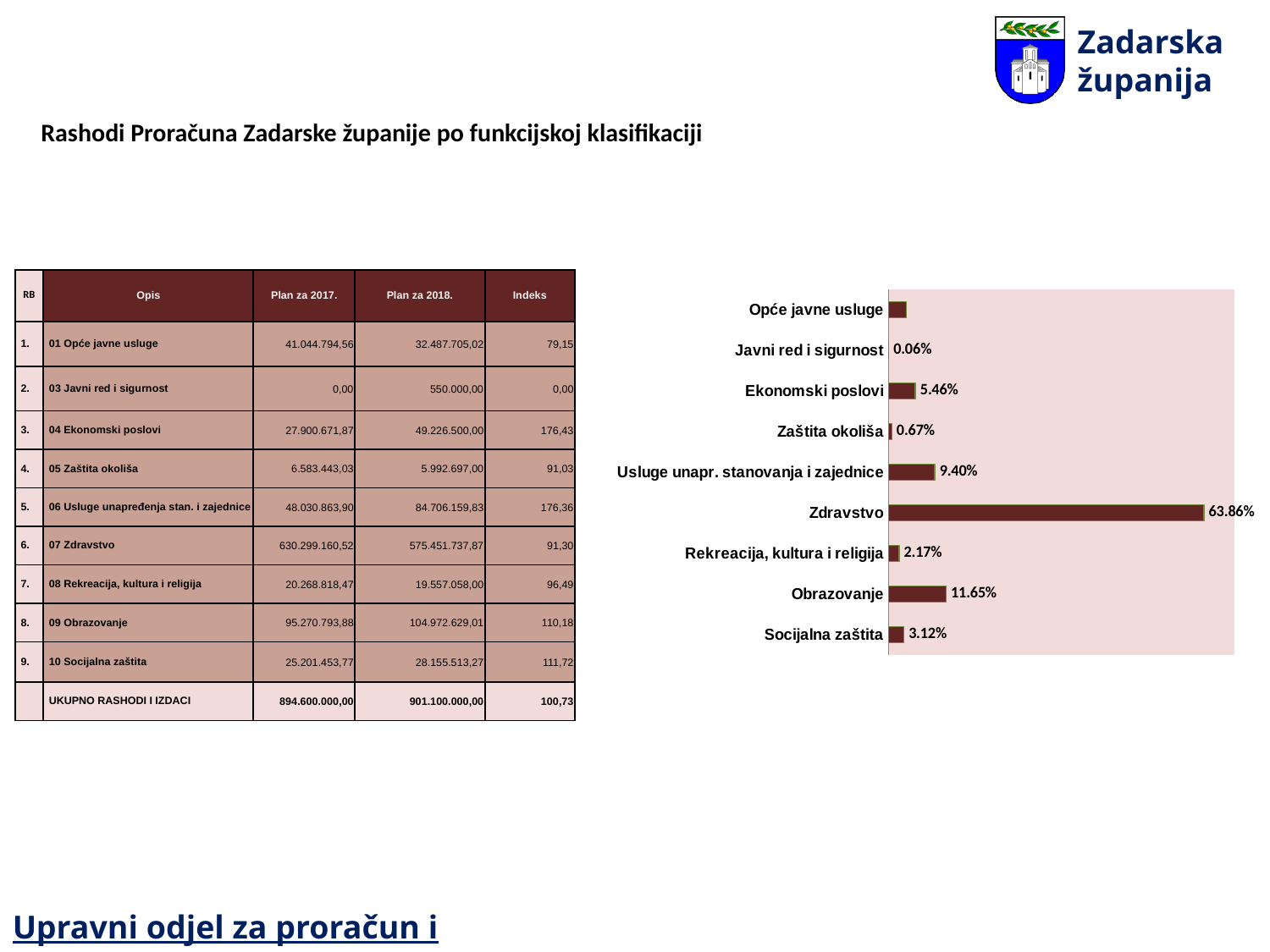
In the bar chart, which labelled category has the lowest value? Javni red i sigurnost What kind of chart is shown on the right side of the slide? bar chart How many categories are shown in the bar chart? 9 In the bar chart, what is the value for Ekonomski poslovi? 5.46% In the bar chart, what is the value for Obrazovanje? 11.65% In the bar chart, what is the value for Socijalna zaštita? 3.12% In the bar chart, which is larger: Obrazovanje or Usluge unapr. stanovanja i zajednice? Obrazovanje In the bar chart, what is the value for Javni red i sigurnost? 0.06% In the bar chart, which category has the highest value? Zdravstvo In the bar chart, what is the difference between Zdravstvo and Obrazovanje? 52.21% In the bar chart, what is the value for Zdravstvo? 63.86% In the bar chart, what is the value for Usluge unapr. stanovanja i zajednice? 9.40%